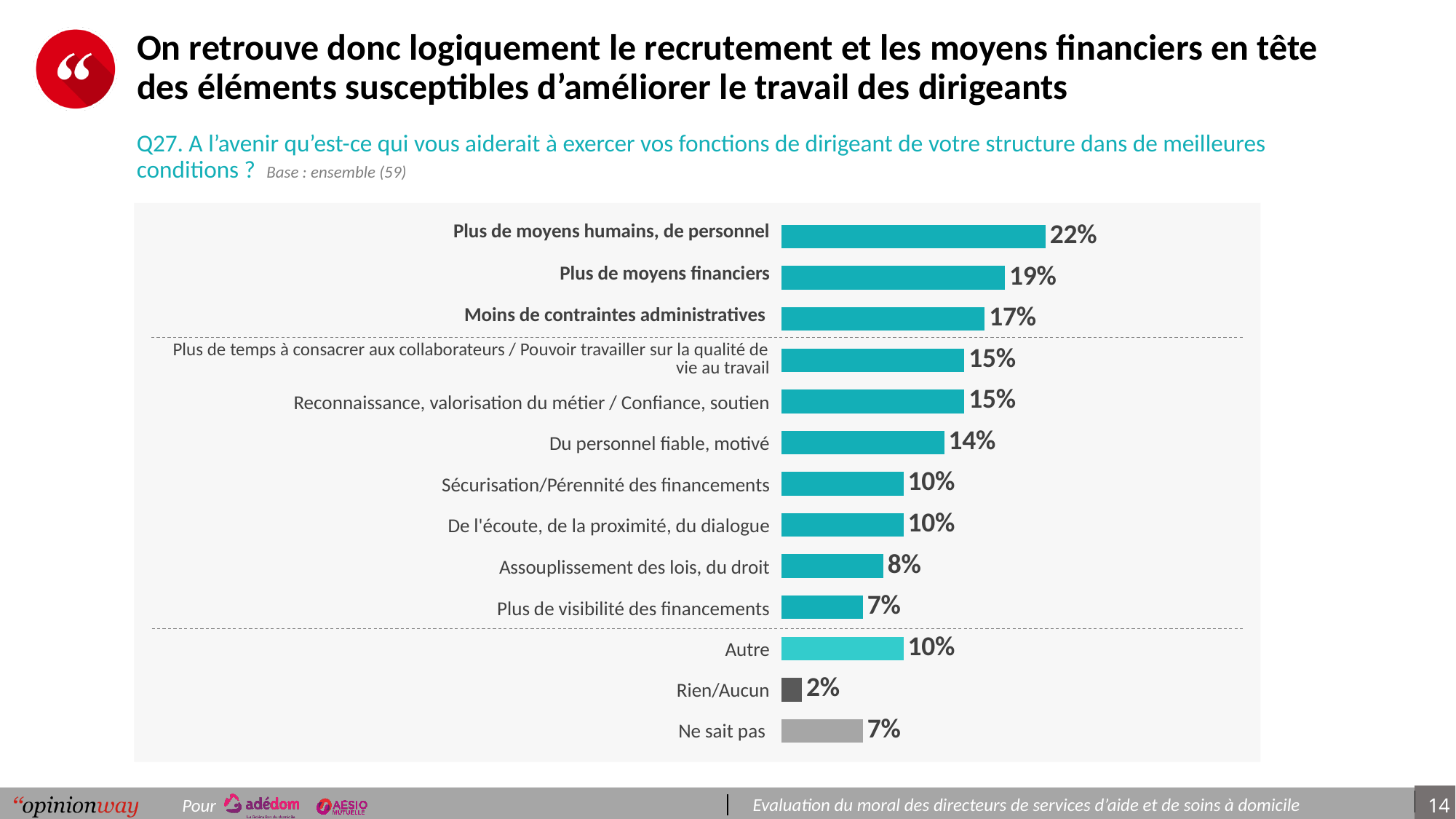
Which is larger: "Plus de moyens financiers" or "Sécurisation/Pérennité des financements"? Plus de moyens financiers Which category has the highest value? Plus de moyens humains, de personnel What is the base (number of respondents) indicated for the question? 59 What is the value for "Plus de moyens humains, de personnel"? 22% What is the value for "Assouplissement des lois, du droit"? 8% What is the difference between "Plus de moyens humains, de personnel" and "Plus de moyens financiers"? 3% What is the difference between "Du personnel fiable, motivé" and "Plus de visibilité des financements"? 7% What kind of chart is shown on the slide? Bar chart How many categories are shown in the chart? 13 What is the value for "Moins de contraintes administratives"? 17% Which category has the lowest value? Rien/Aucun What is the value for "Rien/Aucun"? 2%